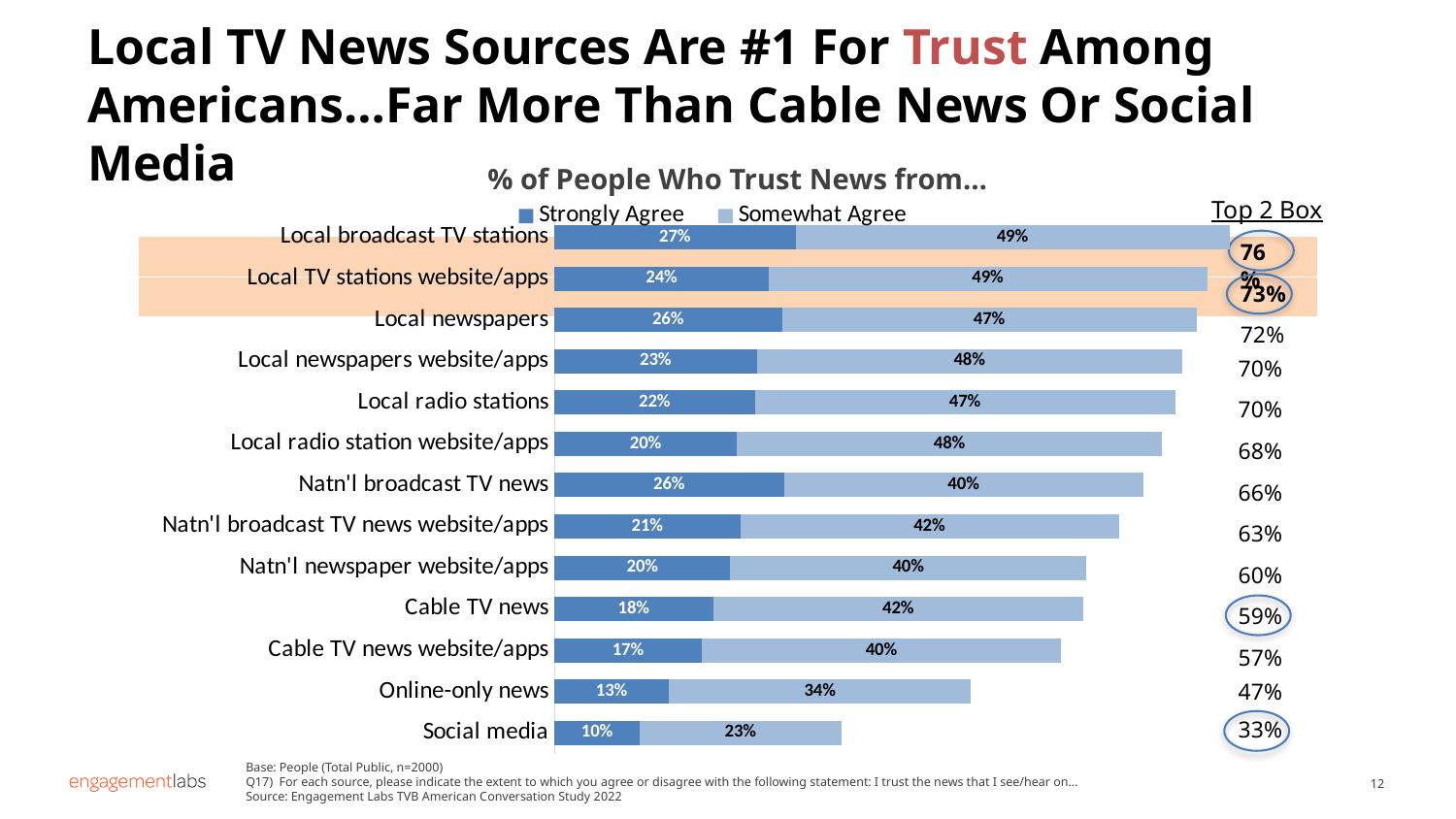
What kind of chart is shown on the slide? Stacked bar chart How many series does the legend list? 2 What is the difference between the Strongly Agree values for Local broadcast TV stations and Social media? 17 percentage points What is the Top 2 Box value shown for Local newspapers? 72% What is the Somewhat Agree value for Social media? 23% Which has a larger Somewhat Agree value, Cable TV news or Natn'l broadcast TV news? Cable TV news What is the combined Strongly Agree and Somewhat Agree total for Online-only news? 47% What is the Strongly Agree value for Cable TV news? 18% Which news source has the highest Strongly Agree value? Local broadcast TV stations Which news source has the lowest Somewhat Agree value? Social media How many news sources are shown in the chart? 13 What is the title of the chart? % of People Who Trust News from…